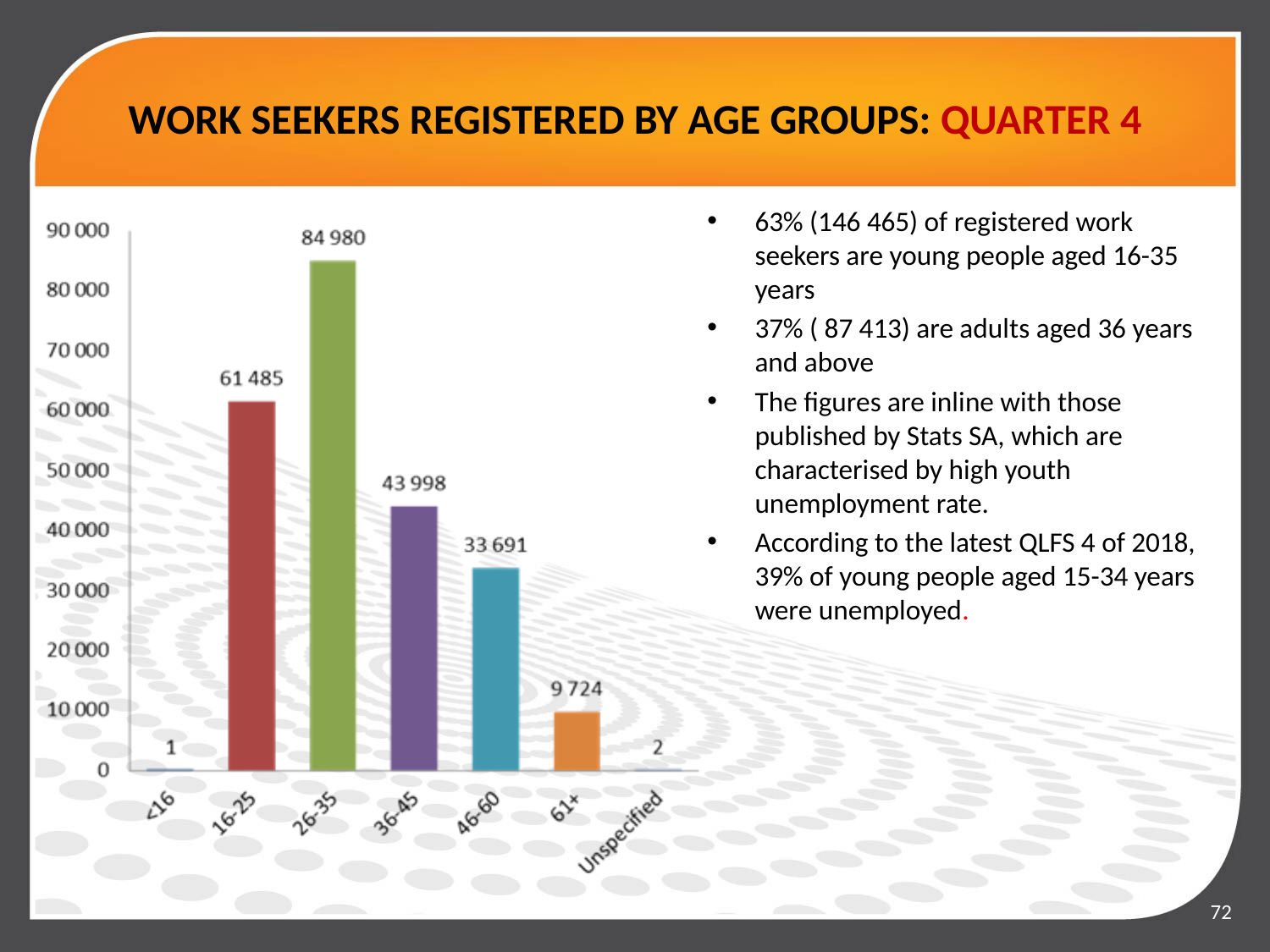
Which age group has more registered work seekers, 36-45 or 46-60? 36-45 What is the difference between the number of registered work seekers aged 26-35 and those aged 16-25? 23 495 Which age group has the highest number of registered work seekers? 26-35 What is the number of registered work seekers in the 26-35 age group? 84 980 Which age group has the lowest number of registered work seekers? <16 What is the value shown for the Unspecified category? 2 Is the value for the 36-45 age group greater or less than 40 000? greater What is the number of registered work seekers in the 46-60 age group? 33 691 What kind of chart is shown on the slide? Bar chart What is the number of registered work seekers in the 16-25 age group? 61 485 How many age group categories are shown on the chart? 7 What is the number of registered work seekers in the 61+ age group? 9 724